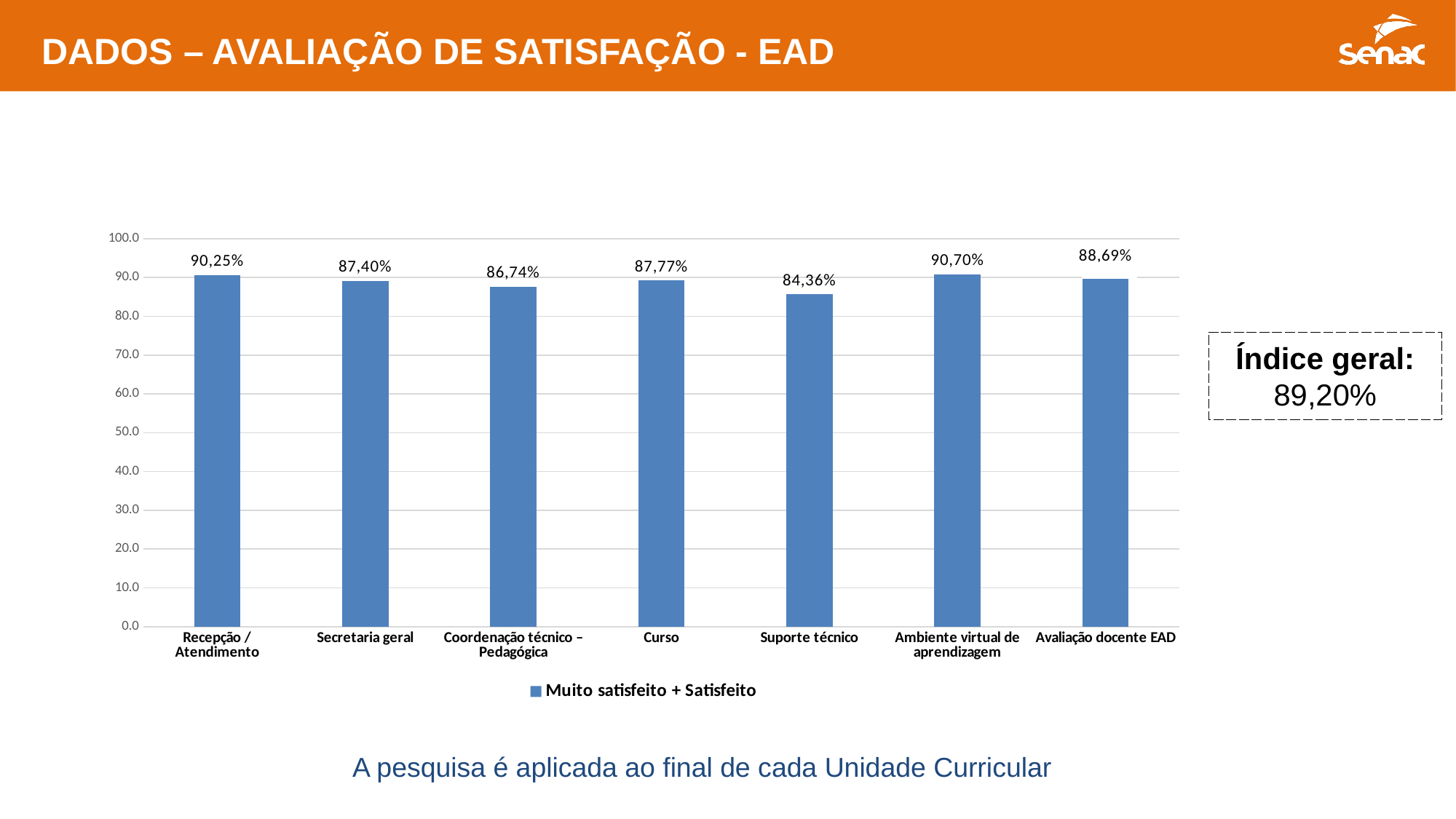
What is the difference between the values for Recepção / Atendimento and Suporte técnico? 5,89% Which category has the highest value? Ambiente virtual de aprendizagem What is the value for Avaliação docente EAD? 88,69% What is the value for Suporte técnico? 84,36% How many categories are shown on the x axis? 7 Which category has the lowest value? Suporte técnico What is the value for Recepção / Atendimento? 90,25% What kind of chart is shown on the slide? Bar chart What series does the legend list? Muito satisfeito + Satisfeito What is the value for Ambiente virtual de aprendizagem? 90,70% Which is larger, the value for Curso or the value for Coordenação técnico – Pedagógica? Curso Is the value for Secretaria geral greater or less than 80.0? greater